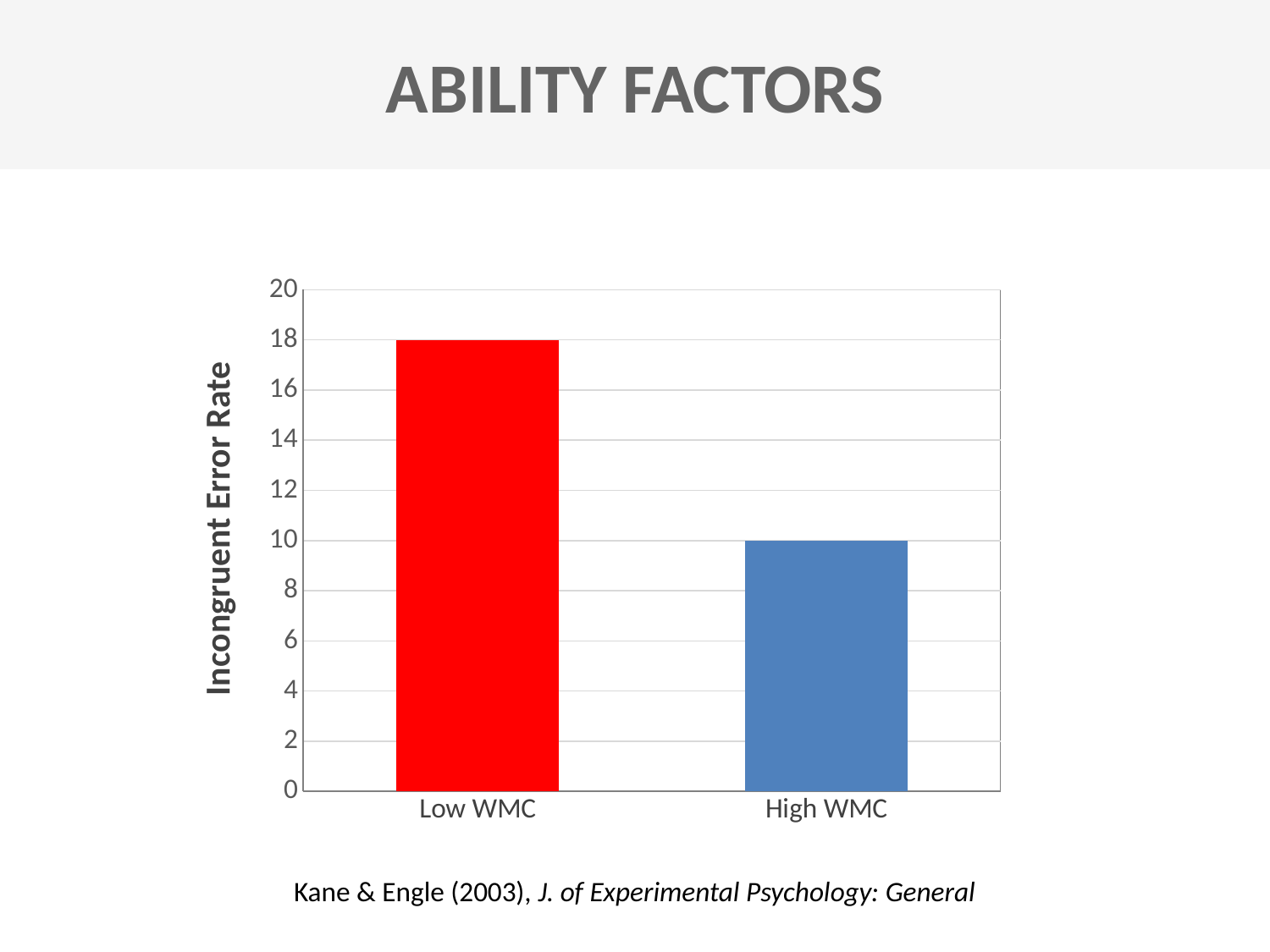
What colour is the bar for Low WMC? Red What is the Incongruent Error Rate for Low WMC? 18 What is the difference in Incongruent Error Rate between Low WMC and High WMC? 8 Which category has the highest Incongruent Error Rate? Low WMC What is the label of the vertical axis of the chart? Incongruent Error Rate Which has a larger Incongruent Error Rate, Low WMC or High WMC? Low WMC How many categories are shown on the x axis of the chart? 2 Which category has the lowest Incongruent Error Rate? High WMC Is the value for High WMC greater or less than 12? less Is the value for Low WMC greater or less than 16? greater What is the Incongruent Error Rate for High WMC? 10 What kind of chart is shown on the slide? Bar chart